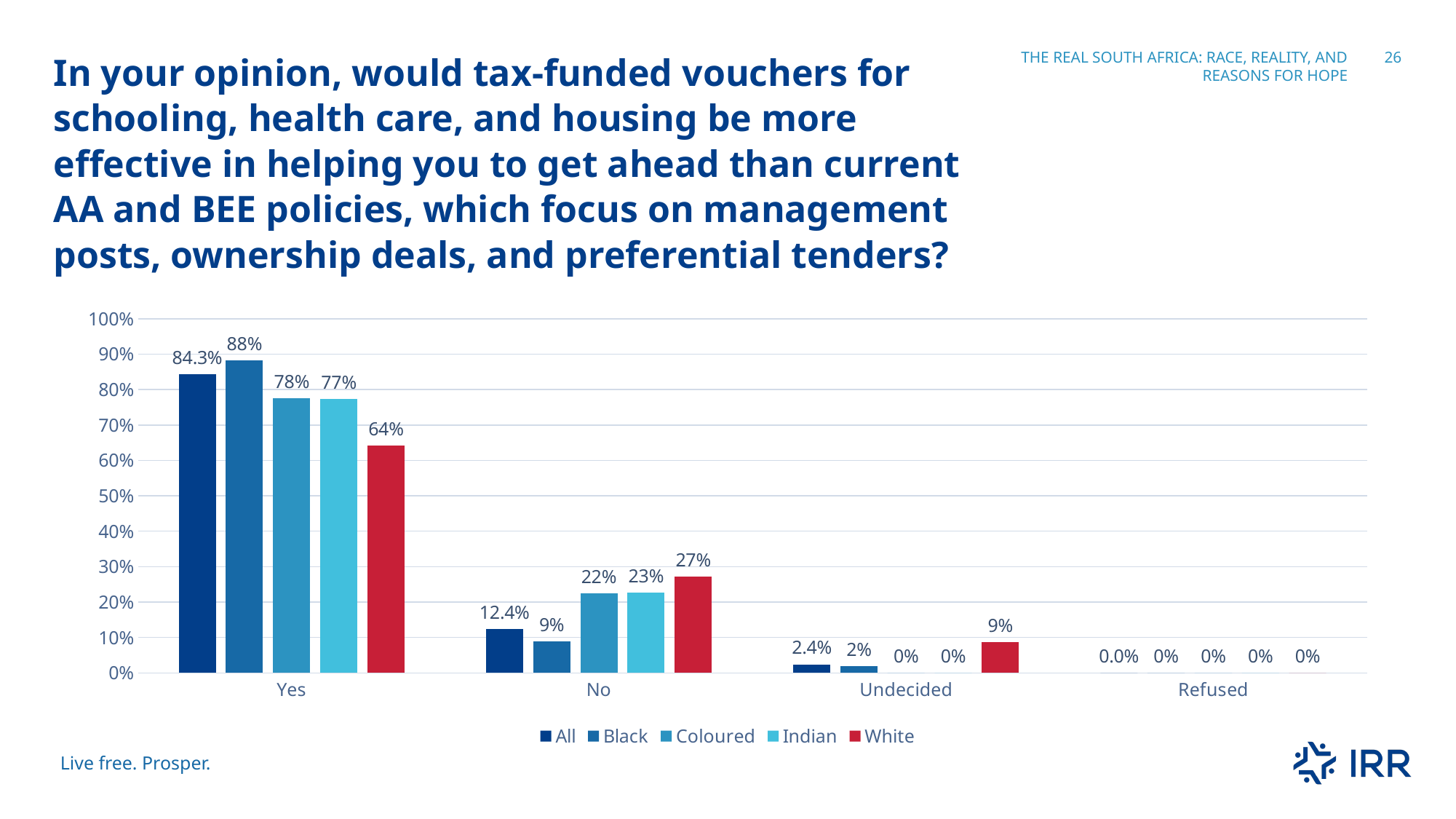
What is the difference between the Black and White values in the Yes category? 24% What is the value for White respondents in the No category? 27% What is the value for Black respondents in the Yes category? 88% Which series has the highest value in the Yes category? Black What is the value for All respondents in the Undecided category? 2.4% Which colour represents the White series in the chart? Red How many series does the legend list? 5 How many categories are shown on the x axis? 4 Which series has the lowest value in the Yes category? White What kind of chart is shown on the slide? Bar chart What is the value for Indian respondents in the No category? 23% Which is larger in the No category: the value for Coloured or the value for Black? Coloured